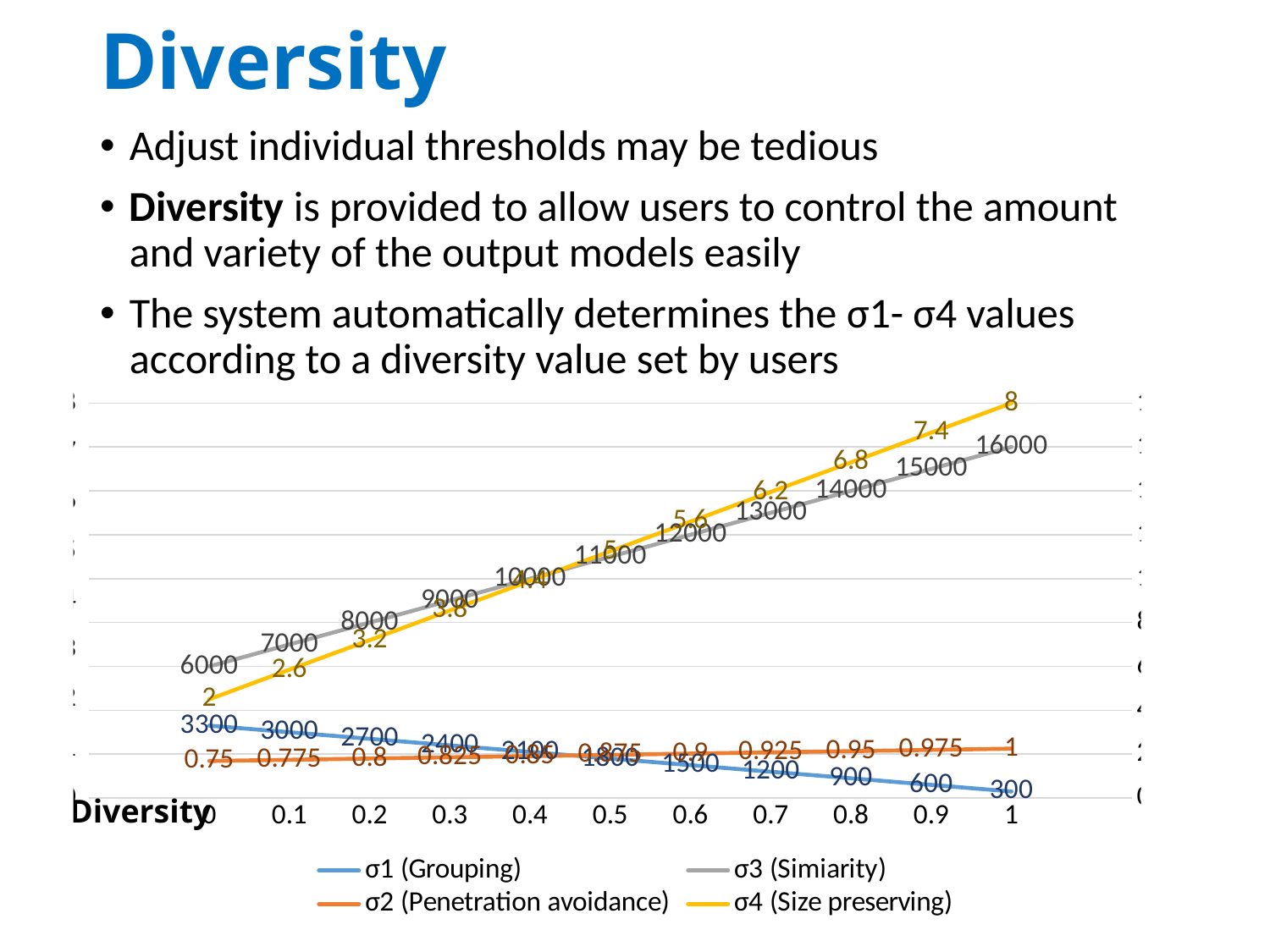
At which diversity value is σ1 (Grouping) lowest? 1 How many diversity values are plotted along the x axis? 11 What is the value of σ4 (Size preserving) at diversity 1? 8 What kind of chart is shown on the slide? line chart How many series does the legend list? 4 What is the difference between σ3 (Simiarity) at diversity 1 and at diversity 0? 10000 Does σ1 (Grouping) rise or fall as diversity increases? fall What is the value of σ1 (Grouping) at diversity 0? 3300 What is the value of σ3 (Simiarity) at diversity 0.5? 11000 Which series is drawn with the yellow line? σ4 (Size preserving) Does σ3 (Simiarity) rise or fall as diversity increases? rise What is the value of σ2 (Penetration avoidance) at diversity 0.7? 0.925